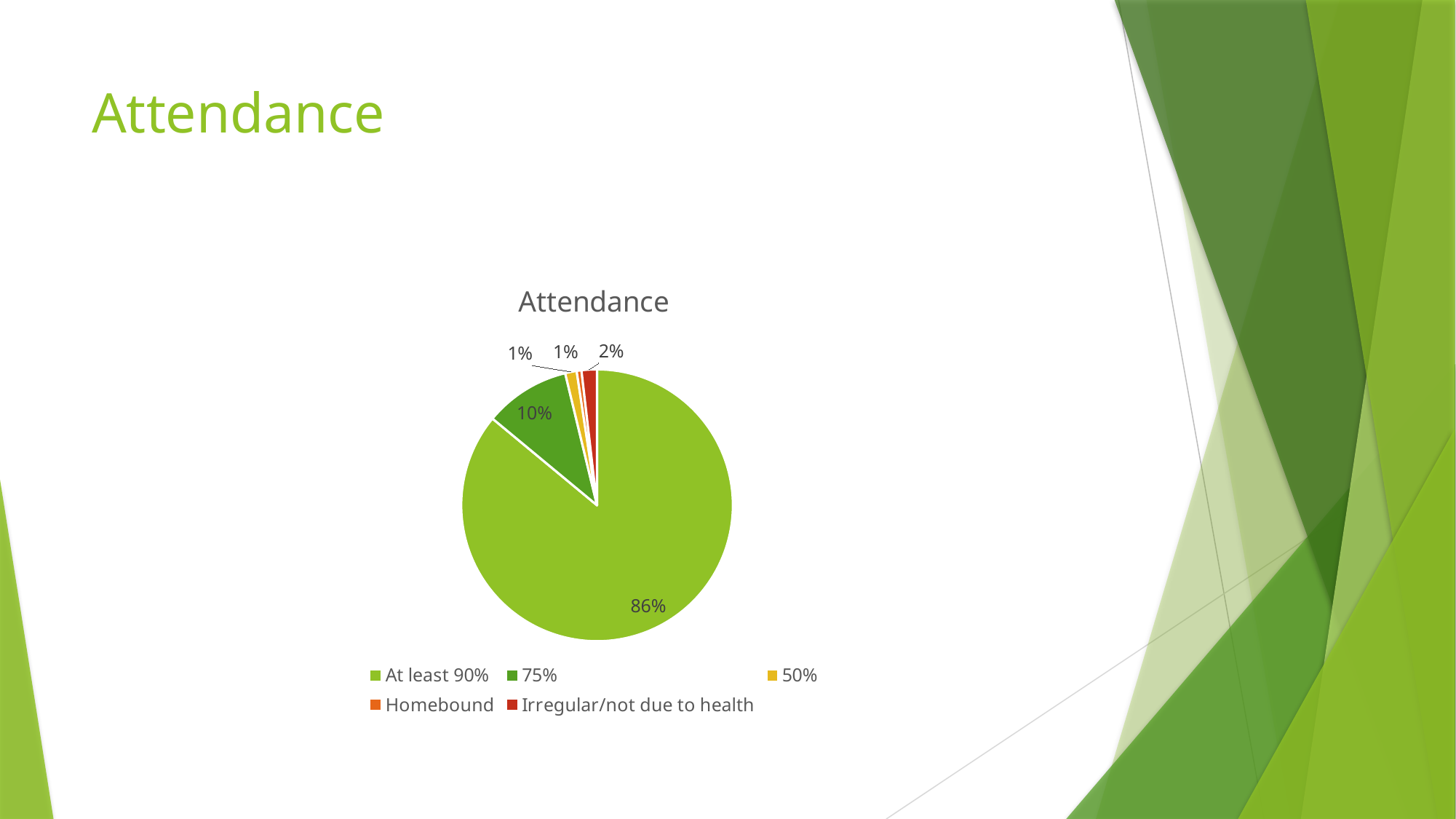
What share of the pie does the 'At least 90%' slice represent? 86% Which is larger, the '75%' slice or the 'Irregular/not due to health' slice? 75% What is the title of the chart? Attendance What share of the pie does the 'Irregular/not due to health' slice represent? 2% What colour is the 'Irregular/not due to health' slice? red What share of the pie does the 'Homebound' slice represent? 1% How many categories does the legend list? 5 What type of chart is shown on the slide? pie chart Which category has the largest slice of the pie? At least 90% What is the difference between the 'At least 90%' share and the '75%' share? 76%